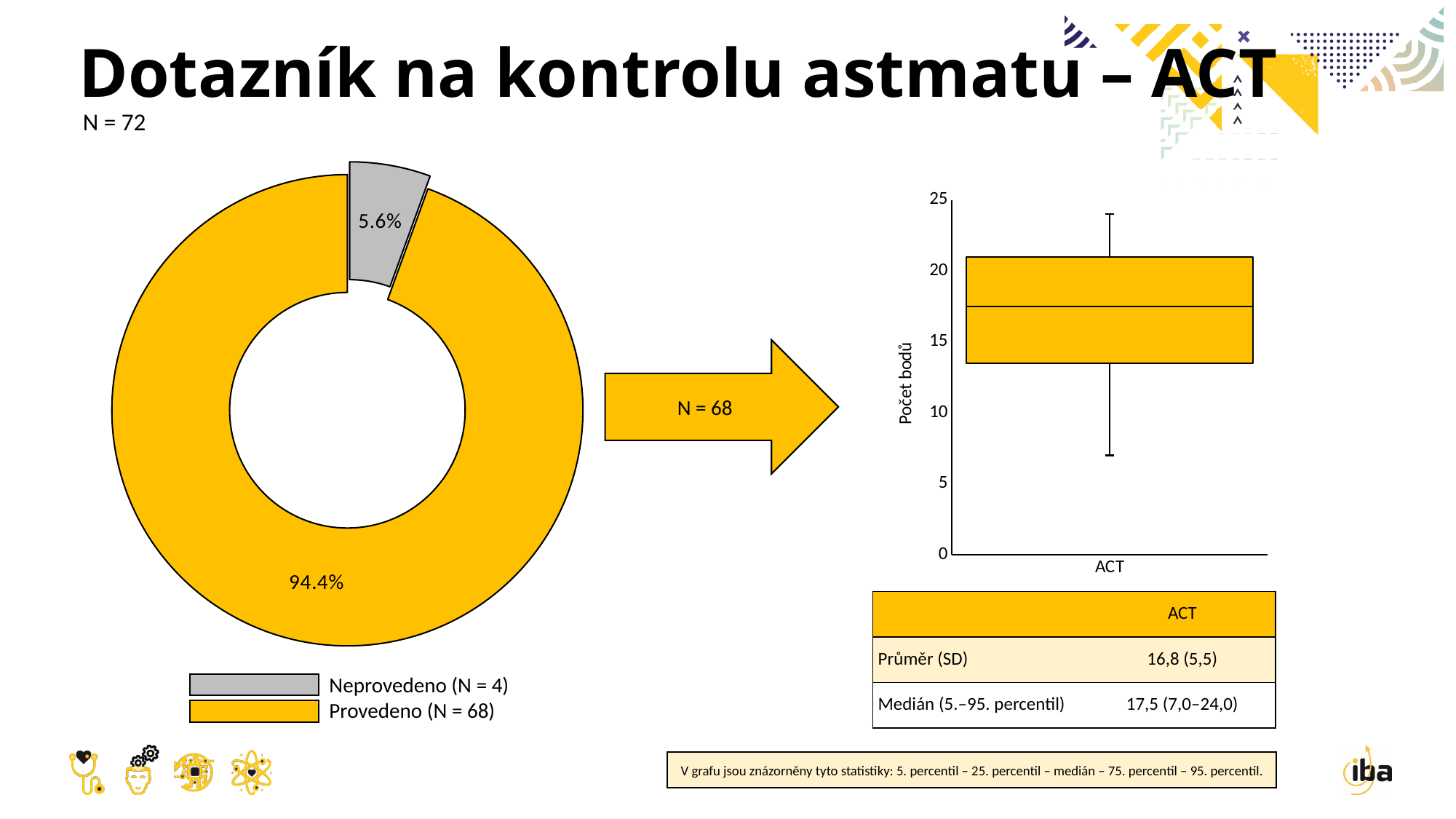
In the donut chart on the left, which category has the smallest share? Neprovedeno In the donut chart on the left, what percentage is shown for the Neprovedeno slice? 5.6% In the box plot on the right, what is the label of the y axis? Počet bodů In the box plot on the right, is the lower whisker end for ACT greater or less than 10? less In the donut chart on the left, how many categories are shown? 2 What kind of chart is the chart on the left of the slide? Pie chart (donut) In the box plot on the right, is the median line for ACT greater or less than 15? greater In the donut chart on the left, which category has the larger share? Provedeno What kind of chart is the chart on the right of the slide? Box plot In the donut chart on the left, what is the N given in the legend for Neprovedeno? N = 4 In the donut chart on the left, what is the difference in percentage points between the Provedeno and Neprovedeno shares? 88.8 percentage points In the donut chart on the left, what percentage is shown for the Provedeno slice? 94.4%